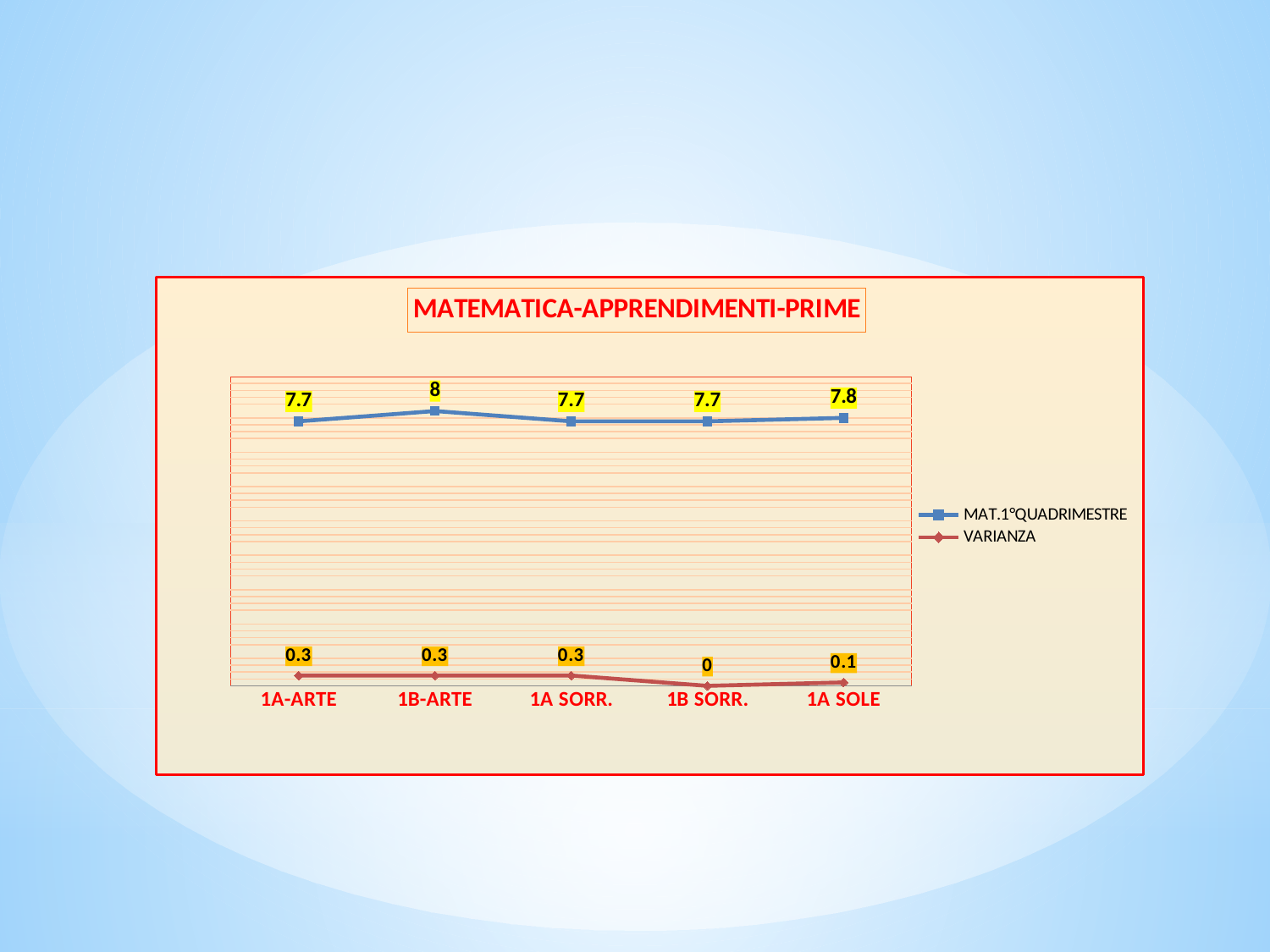
What is the MAT.1°QUADRIMESTRE value for 1A SOLE? 7.8 What is the title of the chart? MATEMATICA-APPRENDIMENTI-PRIME Which is larger, the MAT.1°QUADRIMESTRE value for 1A SOLE or for 1B SORR.? 1A SOLE How many series does the legend list? 2 What is the MAT.1°QUADRIMESTRE value for 1B-ARTE? 8 Which category has the highest MAT.1°QUADRIMESTRE value? 1B-ARTE How many categories are shown on the x axis? 5 What kind of chart is shown? line chart Which category has the lowest VARIANZA value? 1B SORR. What is the VARIANZA value for 1B SORR.? 0 What is the VARIANZA value for 1A SOLE? 0.1 What is the difference between the MAT.1°QUADRIMESTRE values for 1B-ARTE and 1A-ARTE? 0.3